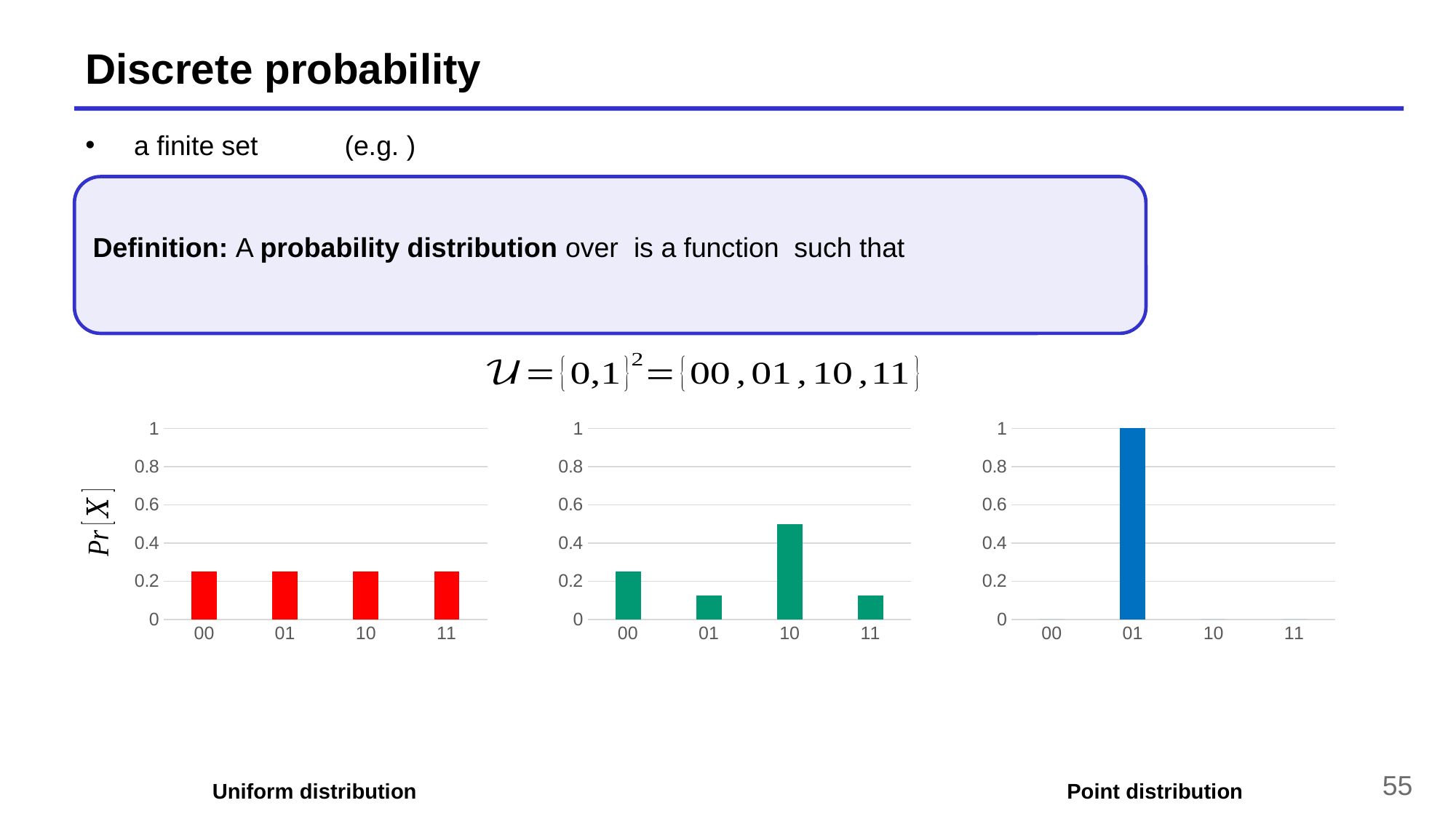
In the Uniform distribution chart, is the value for 00 greater or less than 0.2? greater What is the label on the y axis of the Uniform distribution chart? Pr[X] What kind of chart is the Uniform distribution chart on the left? bar chart In the middle chart, which is larger, the value for 00 or the value for 01? 00 In the Point distribution chart, what is the value for 01? 1 In the middle chart, is the value for 10 greater or less than 0.4? greater How many categories are shown on the x axis of the Uniform distribution chart? 4 In the middle chart, which category has the highest value? 10 What colour are the bars in the Point distribution chart? blue In the Point distribution chart, which category has the highest value? 01 In the Uniform distribution chart, is the value for 11 greater or less than 0.4? less